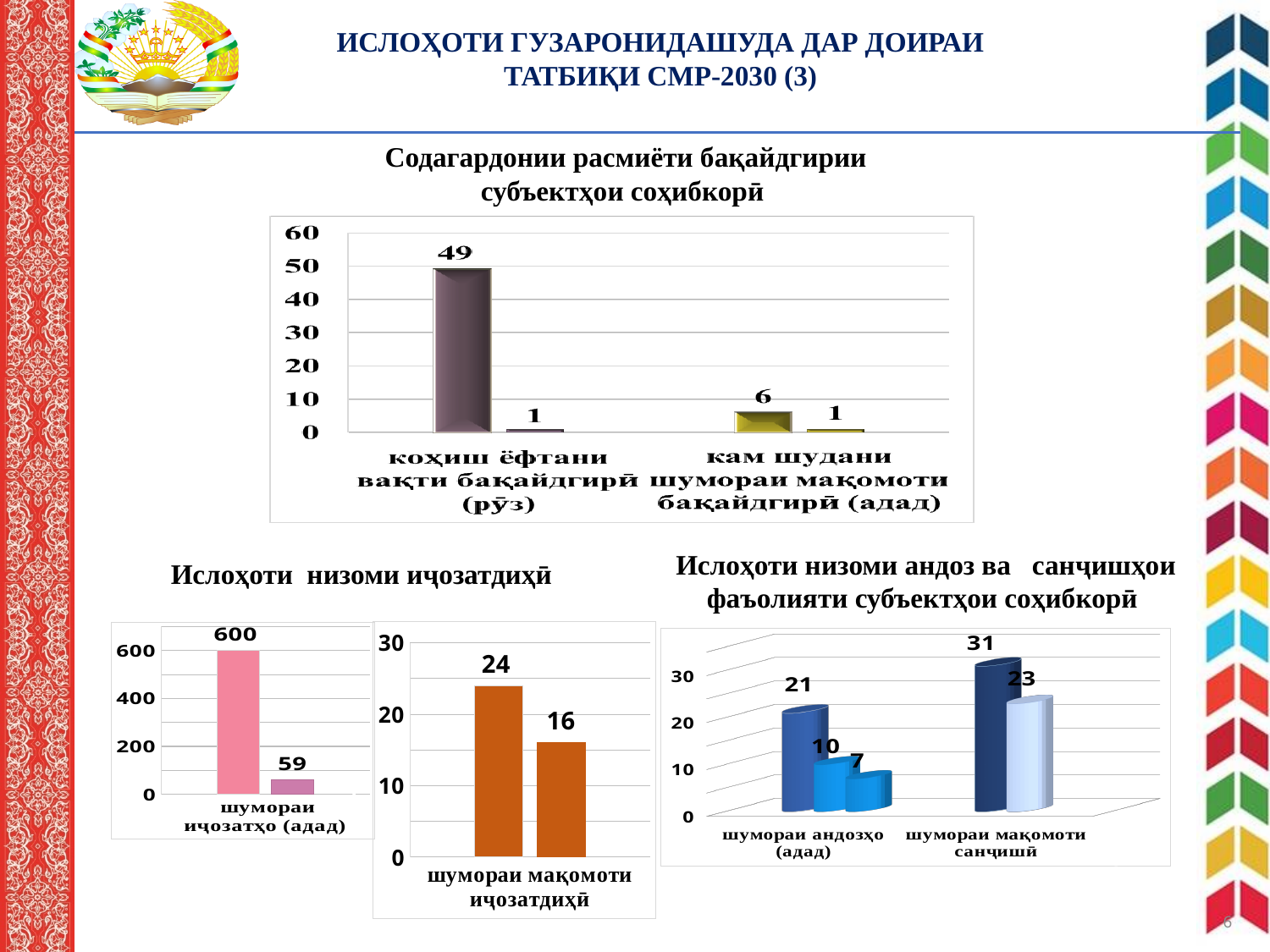
In the bottom-right chart titled 'Ислоҳоти низоми андоз ва санҷишҳои фаъолияти субъектҳои соҳибкорӣ', which is larger: the tallest bar for 'шумораи андозҳо (адад)' or the tallest bar for 'шумораи мақомоти санҷиш'? шумораи мақомоти санҷиш In the bottom-left chart under 'Ислоҳоти низоми иҷозатдиҳӣ', what is the difference between the two bars for 'шумораи иҷозатҳо (адад)'? 541 In the top chart titled 'Содагардонии расмиёти бақайдгирии субъектҳои соҳибкорӣ', what is the value of the taller bar for 'кам шудани шумораи мақомоти бақайдгирӣ (адад)'? 6 In the bottom-left chart under 'Ислоҳоти низоми иҷозатдиҳӣ', what is the value of the taller bar for 'шумораи иҷозатҳо (адад)'? 600 In the bottom-middle chart for 'шумораи мақомоти иҷозатдиҳӣ', what is the value of the shorter bar? 16 In the bottom-right chart titled 'Ислоҳоти низоми андоз ва санҷишҳои фаъолияти субъектҳои соҳибкорӣ', what is the highest value shown for 'шумораи мақомоти санҷиш'? 31 In the bottom-right chart titled 'Ислоҳоти низоми андоз ва санҷишҳои фаъолияти субъектҳои соҳибкорӣ', what is the lowest value shown for 'шумораи андозҳо (адад)'? 7 In the top chart titled 'Содагардонии расмиёти бақайдгирии субъектҳои соҳибкорӣ', what is the value of the tallest bar for 'коҳиш ёфтани вақти бақайдгирӣ (рӯз)'? 49 What kind of chart is the top chart titled 'Содагардонии расмиёти бақайдгирии субъектҳои соҳибкорӣ'? bar chart In the top chart titled 'Содагардонии расмиёти бақайдгирии субъектҳои соҳибкорӣ', how many categories are shown on the x axis? 2 In the bottom-middle chart for 'шумораи мақомоти иҷозатдиҳӣ', what is the difference between the two bars? 8 In the top chart titled 'Содагардонии расмиёти бақайдгирии субъектҳои соҳибкорӣ', what is the difference between the two bars for 'коҳиш ёфтани вақти бақайдгирӣ (рӯз)'? 48